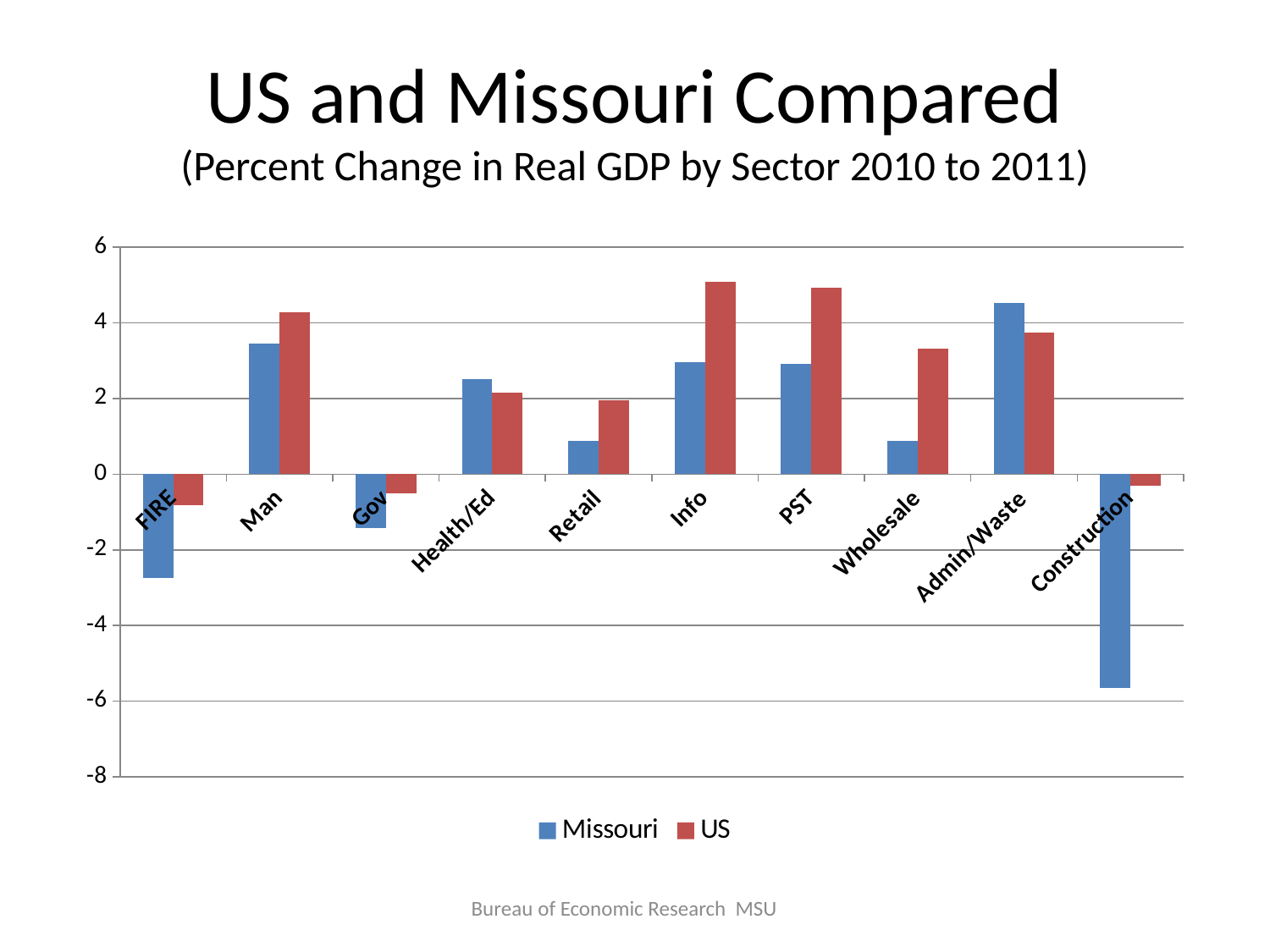
Which sector has the highest Missouri value? Admin/Waste Which sector has the lowest Missouri value? Construction What type of chart is shown on the slide? Bar chart For the Admin/Waste sector, which is larger, the Missouri value or the US value? Missouri How many series does the legend list? 2 Is the US value for Wholesale greater or less than 2? greater Is the Missouri value for FIRE greater or less than -2? less Is the Missouri value for Construction greater or less than -4? less Which two series are listed in the legend? Missouri and US For the Info sector, which is larger, the Missouri value or the US value? US How many sectors (categories) are shown on the x axis? 10